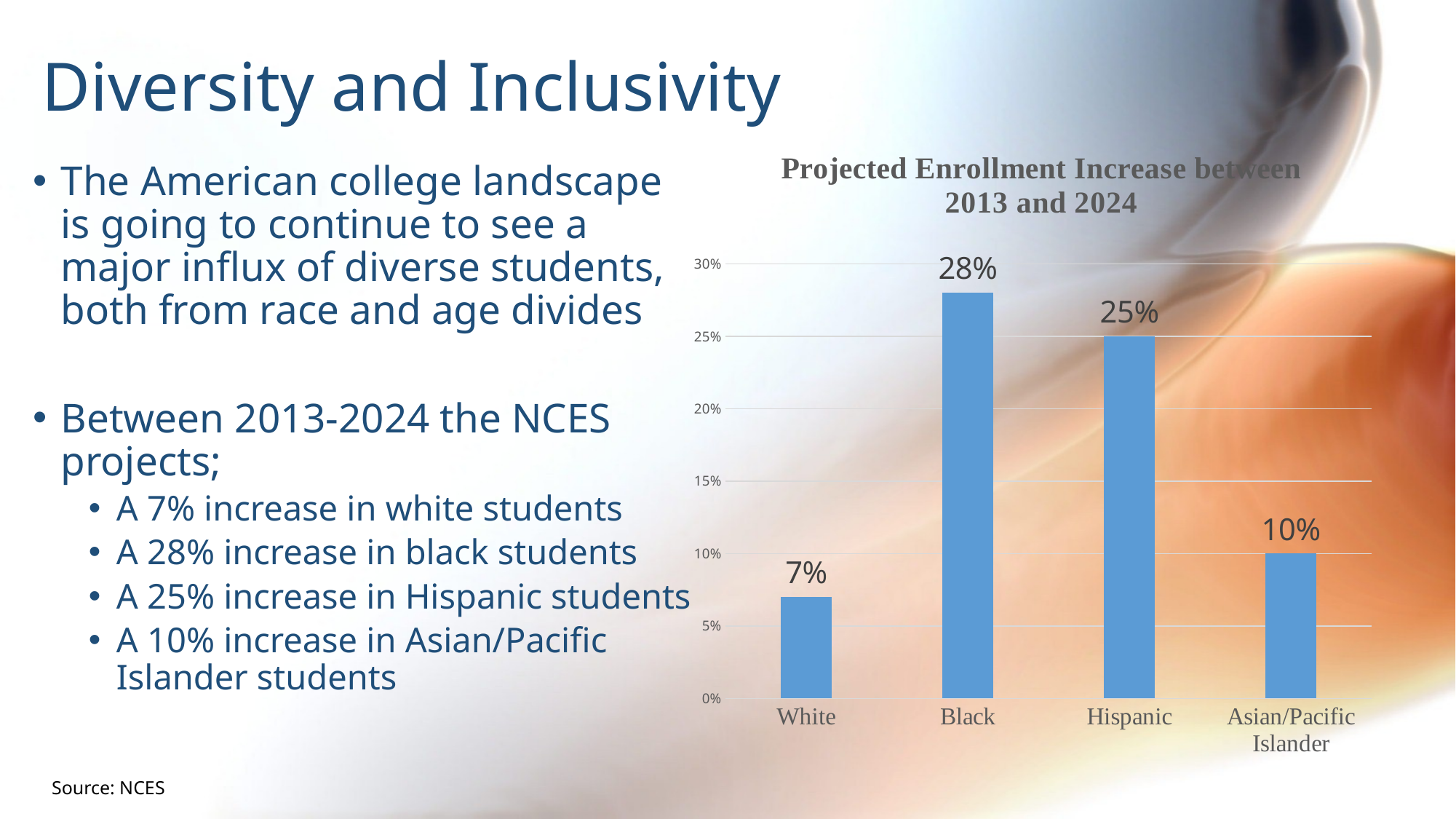
Which category has the lowest projected enrollment increase? White What is the title of the chart? Projected Enrollment Increase between 2013 and 2024 What is the projected enrollment increase for Asian/Pacific Islander students? 10% Which category has the highest projected enrollment increase? Black What kind of chart is shown on the slide? Bar chart Which is larger, the projected increase for Hispanic students or for Asian/Pacific Islander students? Hispanic What is the difference between the projected increase for Hispanic and White students? 18% How many categories are shown in the chart? 4 Is the value for Asian/Pacific Islander greater or less than 15%? less What is the difference between the projected increase for Black and Hispanic students? 3% What is the projected enrollment increase for Black students? 28% What is the projected enrollment increase for White students? 7%